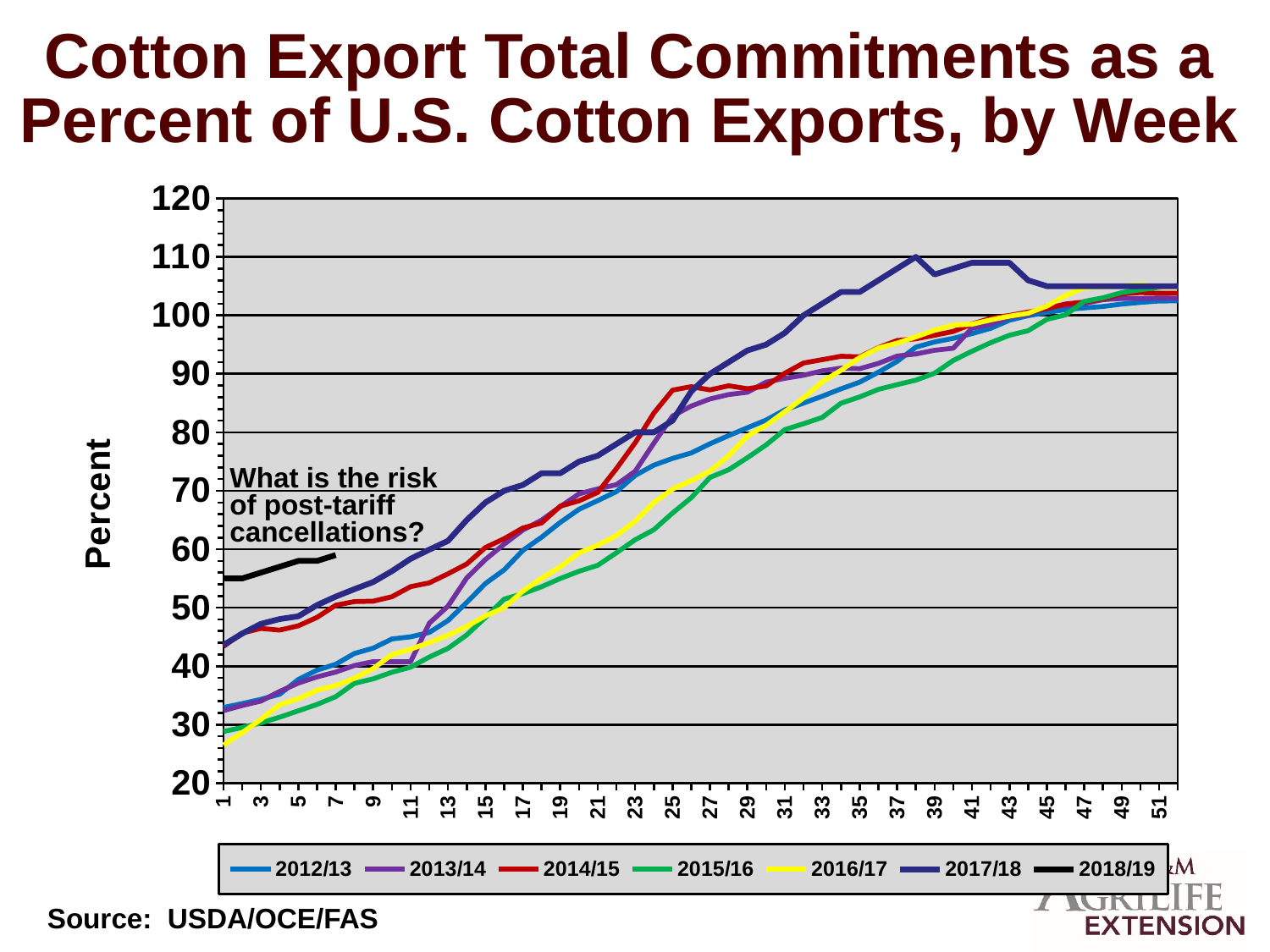
Which series has the highest value at week 1? 2018/19 Is the value for 2018/19 at week 1 greater or less than 50? greater Is the value for 2015/16 at week 25 greater or less than 70? less What is the label on the vertical axis? Percent At week 37, which series has the larger value, 2017/18 or 2015/16? 2017/18 What kind of chart is shown on the slide? line chart How many series does the legend list? 7 Which series has the lowest value at week 1? 2016/17 What source is cited for the chart data? USDA/OCE/FAS Is the value for 2016/17 at week 1 greater or less than 30? less Do the values for the 2014/15 series generally rise or fall as the week number increases? rise